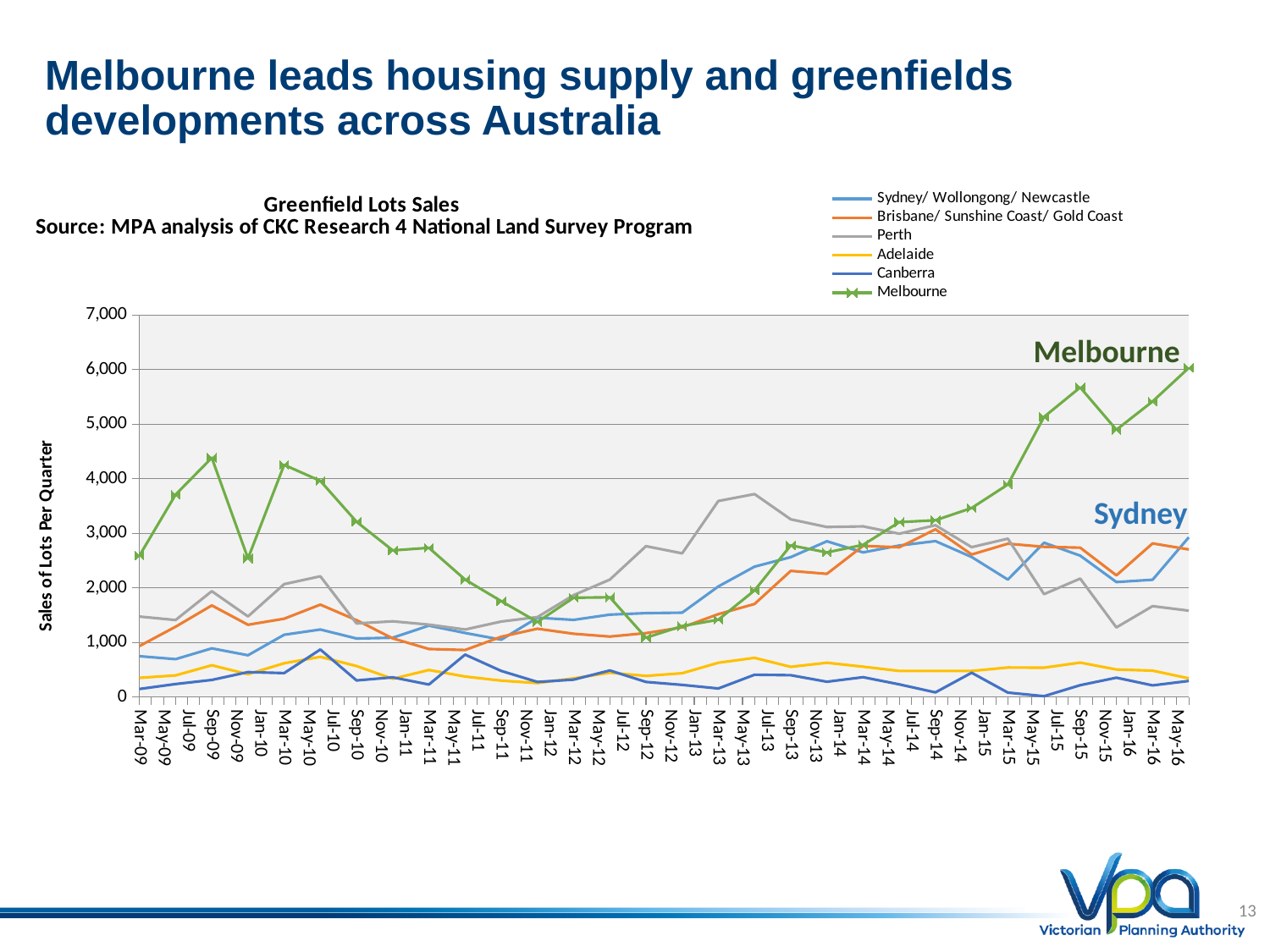
Is the Melbourne value at May-16 greater or less than 5,000? greater How many series does the legend list? 6 What kind of chart is shown on the slide? line chart Which series has the highest value at May-16? Melbourne What is the label on the vertical axis? Sales of Lots Per Quarter Is the Perth value at May-13 greater or less than 3,000? greater Is the Canberra value at May-16 greater or less than 1,000? less At Mar-09, which is higher: Melbourne or Perth? Melbourne Which series has the lowest value at Mar-09? Canberra What is the title of the chart? Greenfield Lots Sales Does the Melbourne line generally rise or fall from Sep-11 to May-16? rise Which series reaches the highest value anywhere on the chart? Melbourne